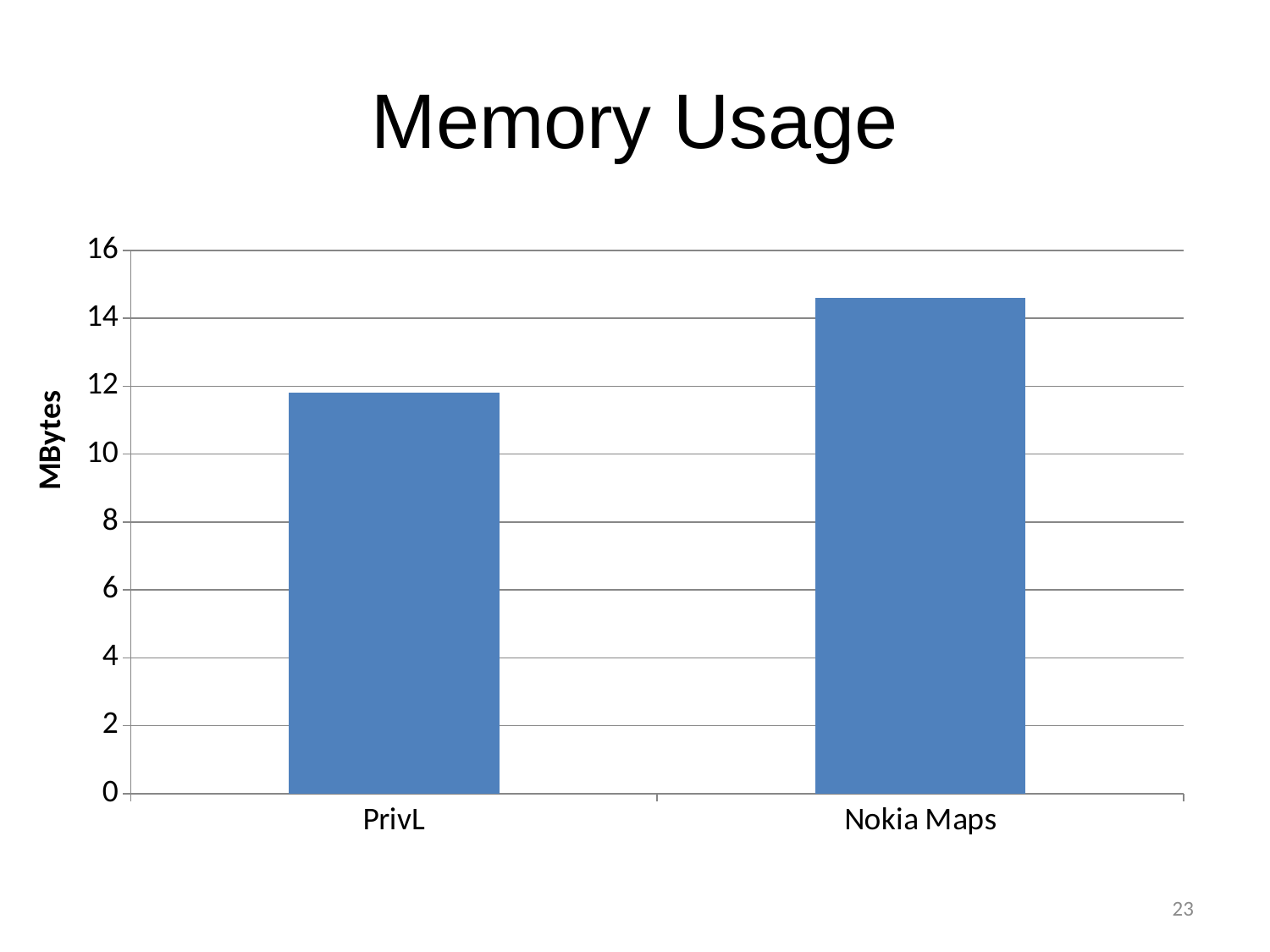
What is the title of the slide? Memory Usage Which uses more memory, PrivL or Nokia Maps? Nokia Maps What kind of chart is shown on the slide? bar chart Is the value for Nokia Maps greater or less than 16? less Is the value for Nokia Maps greater or less than 14? greater What is the maximum value shown on the y axis? 16 Is the value for PrivL greater or less than 10? greater Which category has the lowest memory usage? PrivL What is the label of the y axis? MBytes Which category has the highest memory usage? Nokia Maps How many categories are shown on the x axis? 2